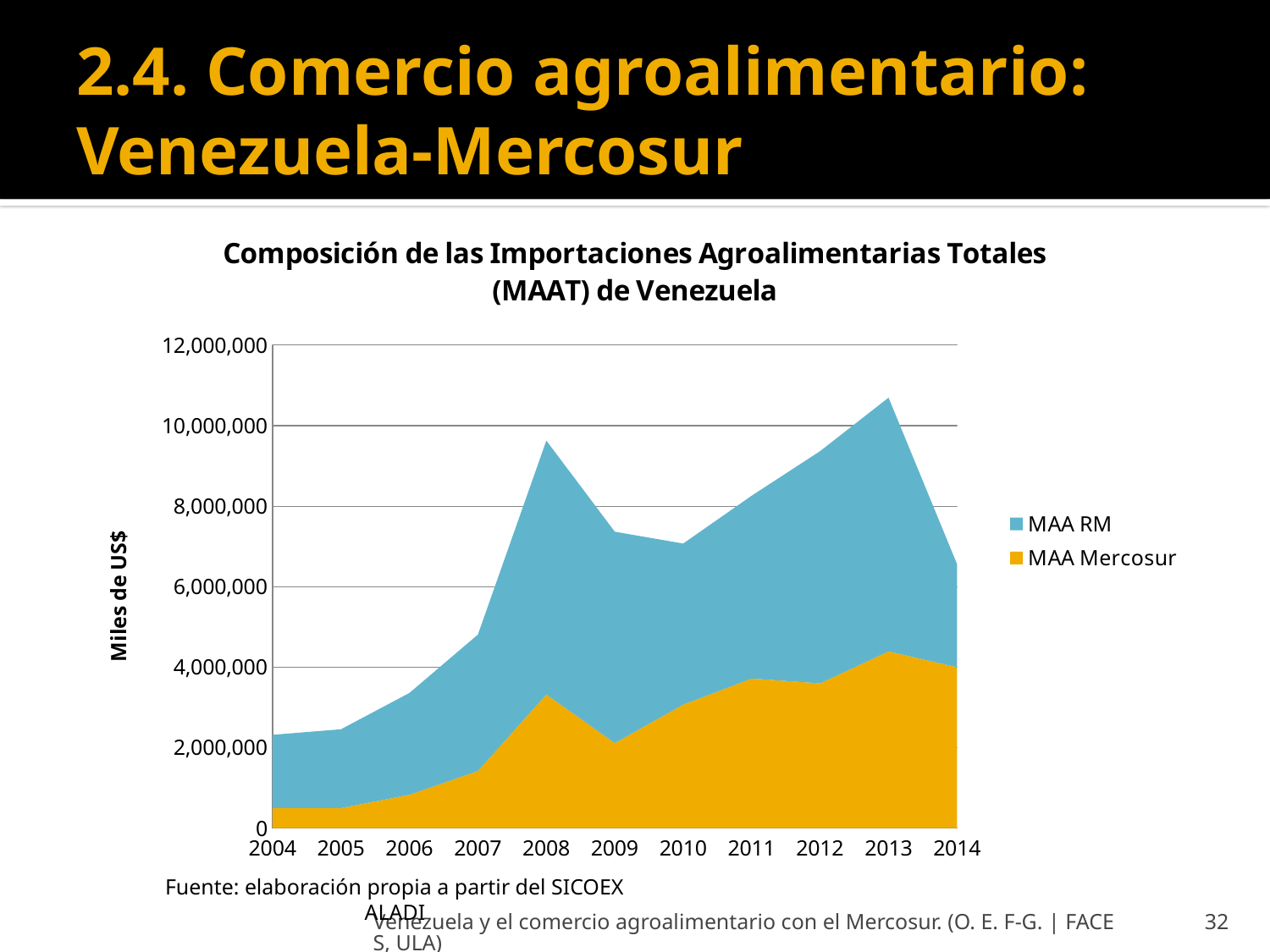
How many years are plotted along the x axis? 11 Which year has the larger total, 2008 or 2009? 2008 What kind of chart is shown on the slide? Stacked area chart Does the total value rise or fall from 2004 to 2008? rise What is the title of the chart? Composición de las Importaciones Agroalimentarias Totales (MAAT) de Venezuela Is the value for MAA Mercosur in 2009 greater or less than 4,000,000? less How many series does the legend list? 2 Is the total value for 2004 greater or less than 4,000,000? less Is the total value for 2008 greater or less than 8,000,000? greater In which year does the total of the stacked areas reach its highest point? 2013 What is the label of the vertical axis? Miles de US$